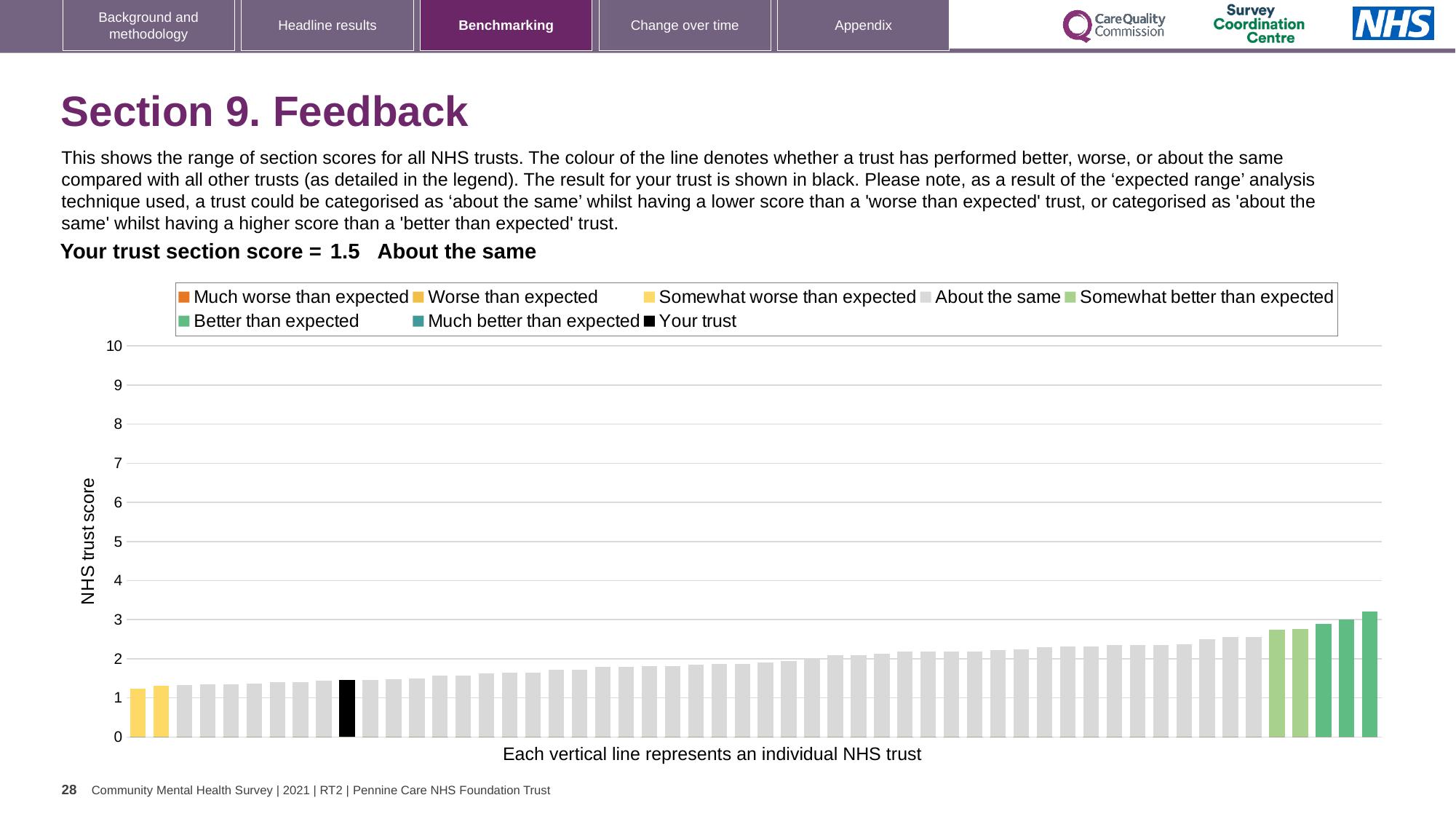
Is the value of the tallest bar greater or less than 3? greater Are all the bars in the chart greater or less than 4? less What kind of chart is shown on the slide? bar chart What is the label on the vertical axis of the chart? NHS trust score What colour is the bar representing your trust? black Do the bar values rise or fall from left to right along the x axis? rise Is the value of the shortest bar greater or less than 2? less How many entries does the chart legend list? 8 Is the black bar for your trust taller or shorter than the tallest dark green bar on the right? shorter Which performance category is your trust placed in for Section 9. Feedback? About the same What is the section score for your trust shown on the slide? 1.5